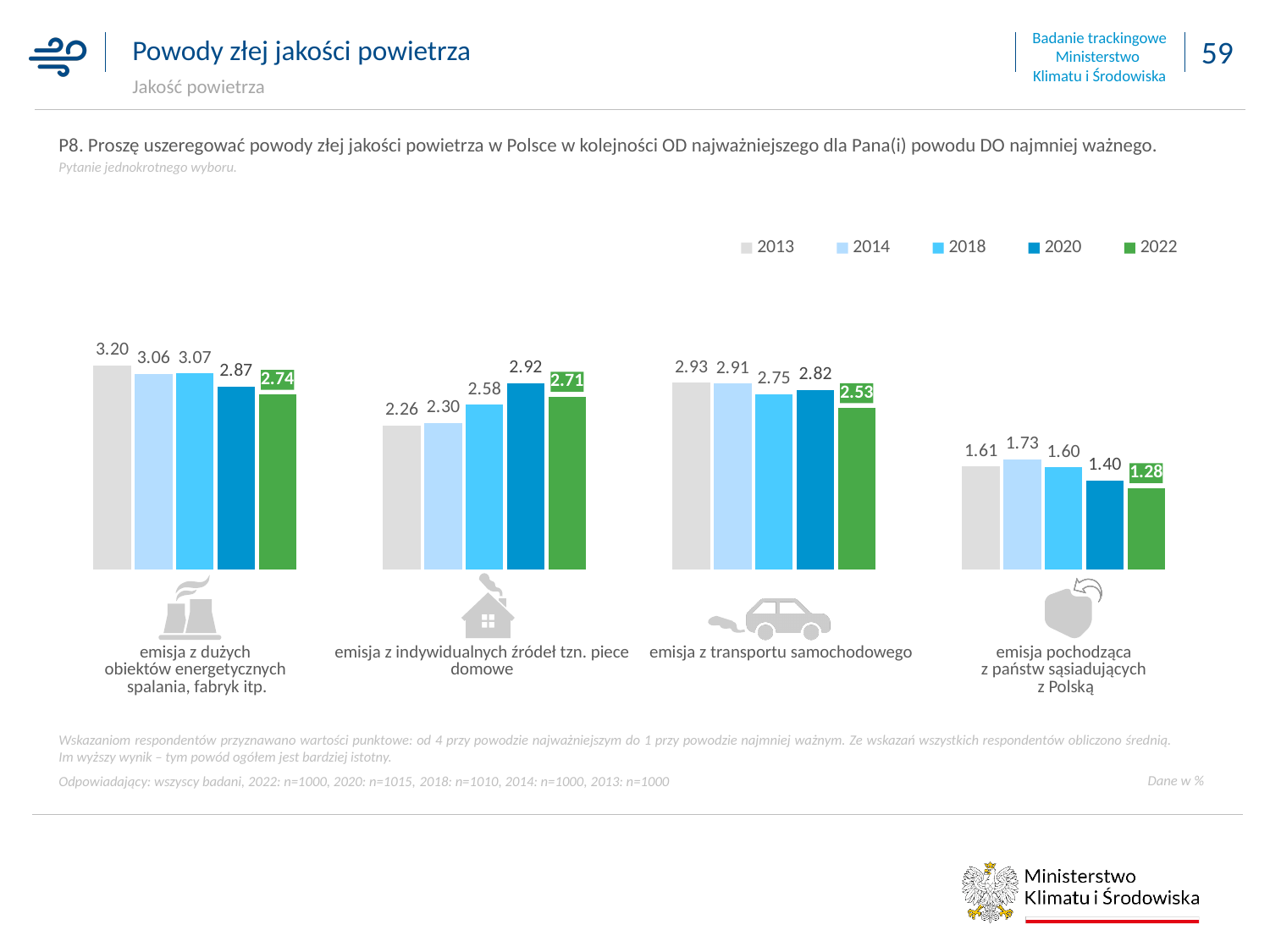
What is the 2022 value for "emisja z dużych obiektów energetycznych spalania, fabryk itp."? 2.74 Which is larger for "emisja z indywidualnych źródeł tzn. piece domowe": the 2020 value or the 2022 value? 2020 How many categories are shown in the chart? 4 Which category has the lowest 2013 value? emisja pochodząca z państw sąsiadujących z Polską How many series does the legend list? 5 What is the 2014 value for "emisja pochodząca z państw sąsiadujących z Polską"? 1.73 What is the 2020 value for "emisja z transportu samochodowego"? 2.82 Do the values for "emisja z indywidualnych źródeł tzn. piece domowe" rise or fall from 2013 to 2020? rise Which category has the highest 2022 value? emisja z dużych obiektów energetycznych spalania, fabryk itp. What is the difference between the 2013 and 2022 values for "emisja z dużych obiektów energetycznych spalania, fabryk itp."? 0.46 What kind of chart is shown on the slide? bar chart What is the 2013 value for "emisja z indywidualnych źródeł tzn. piece domowe"? 2.26